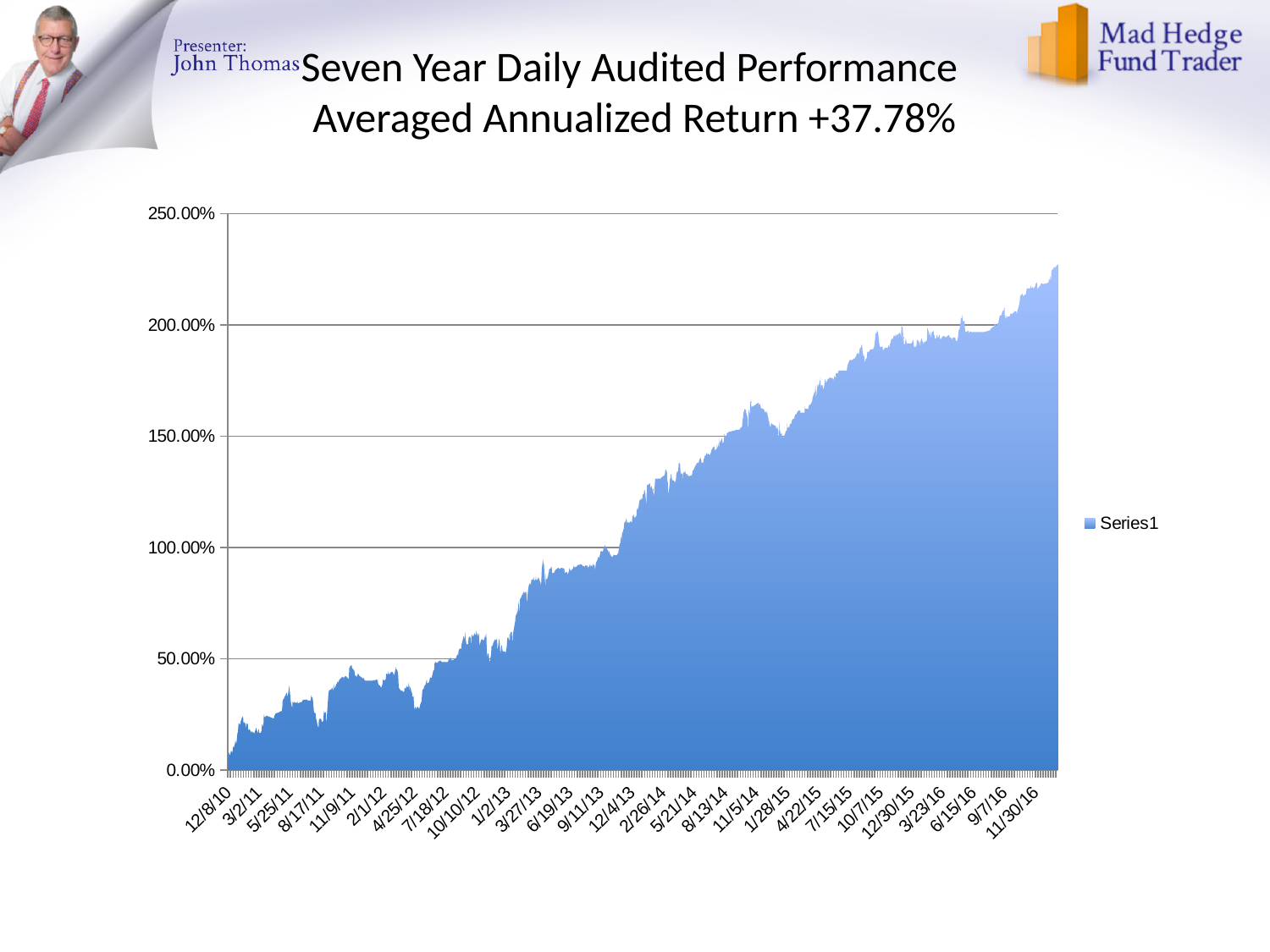
What averaged annualized return is stated in the chart title? +37.78% What kind of chart is shown on the slide? area chart How many series does the legend list? 1 Is the value at 6/19/13 greater or less than 100.00%? less Is the value at 11/30/16 greater or less than 200.00%? greater Is the value at 12/8/10 greater or less than 50.00%? less Which is larger, the value at 11/30/16 or the value at 12/8/10? 11/30/16 Do the values generally rise or fall from 12/8/10 to 11/30/16? rise What is the name of the series shown in the legend? Series1